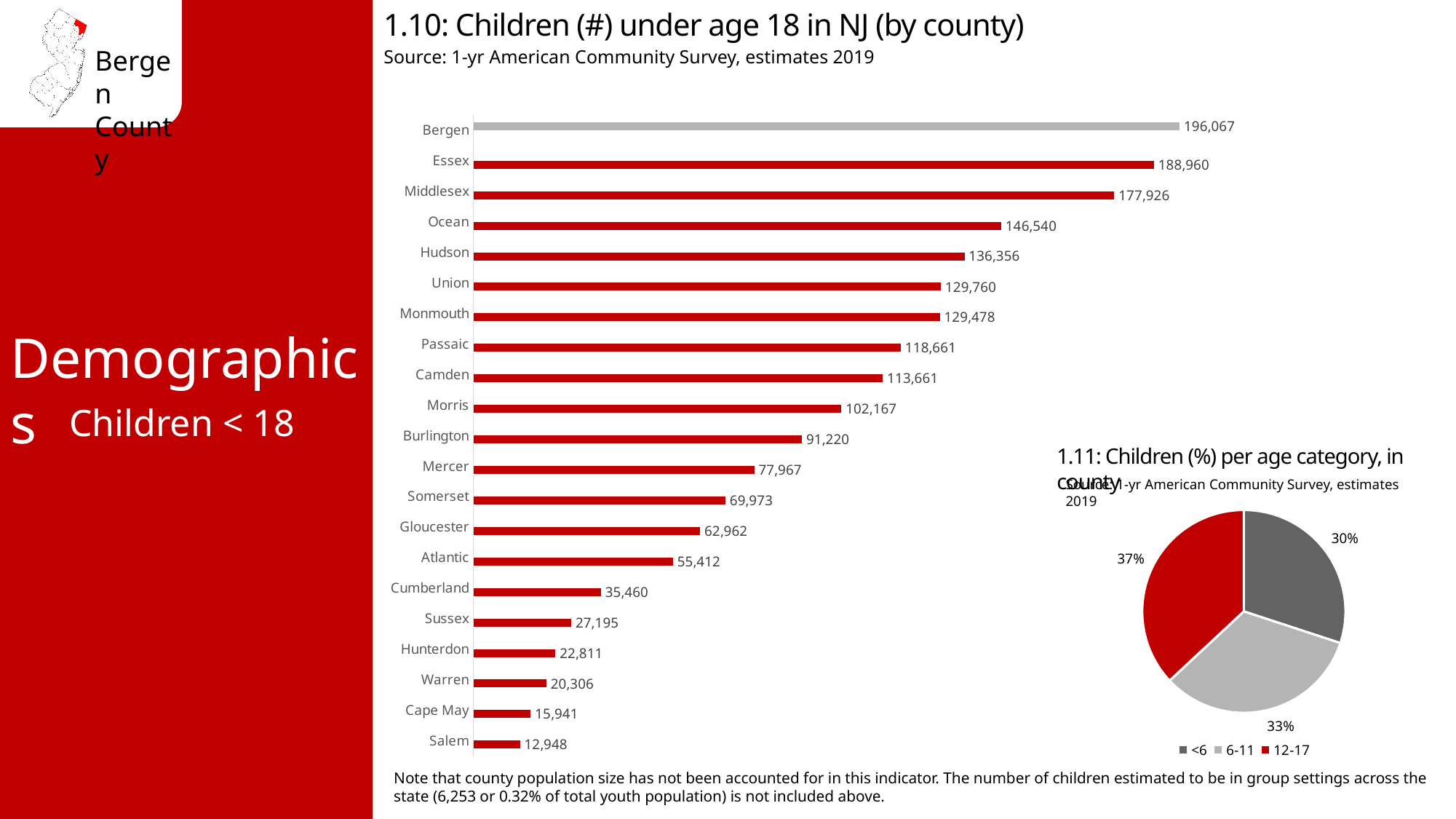
In chart 1.10, what is the value for Ocean County? 146,540 In chart 1.11, which age category has the largest share? 12-17 In chart 1.11, what share of children are in the 12-17 age category? 37% In chart 1.11, what percentage of children are under 6? 30% In chart 1.11, how many age categories does the legend list? 3 What type of chart is chart 1.10? Bar chart In chart 1.10, how many counties are shown? 21 In chart 1.10, what is the difference between Bergen and Essex? 7,107 In chart 1.10, which county has more children under 18, Passaic or Camden? Passaic In chart 1.10, how many children under age 18 are in Bergen County? 196,067 In chart 1.10, which county has the lowest number of children under 18? Salem In chart 1.10, which county has the highest number of children under 18? Bergen